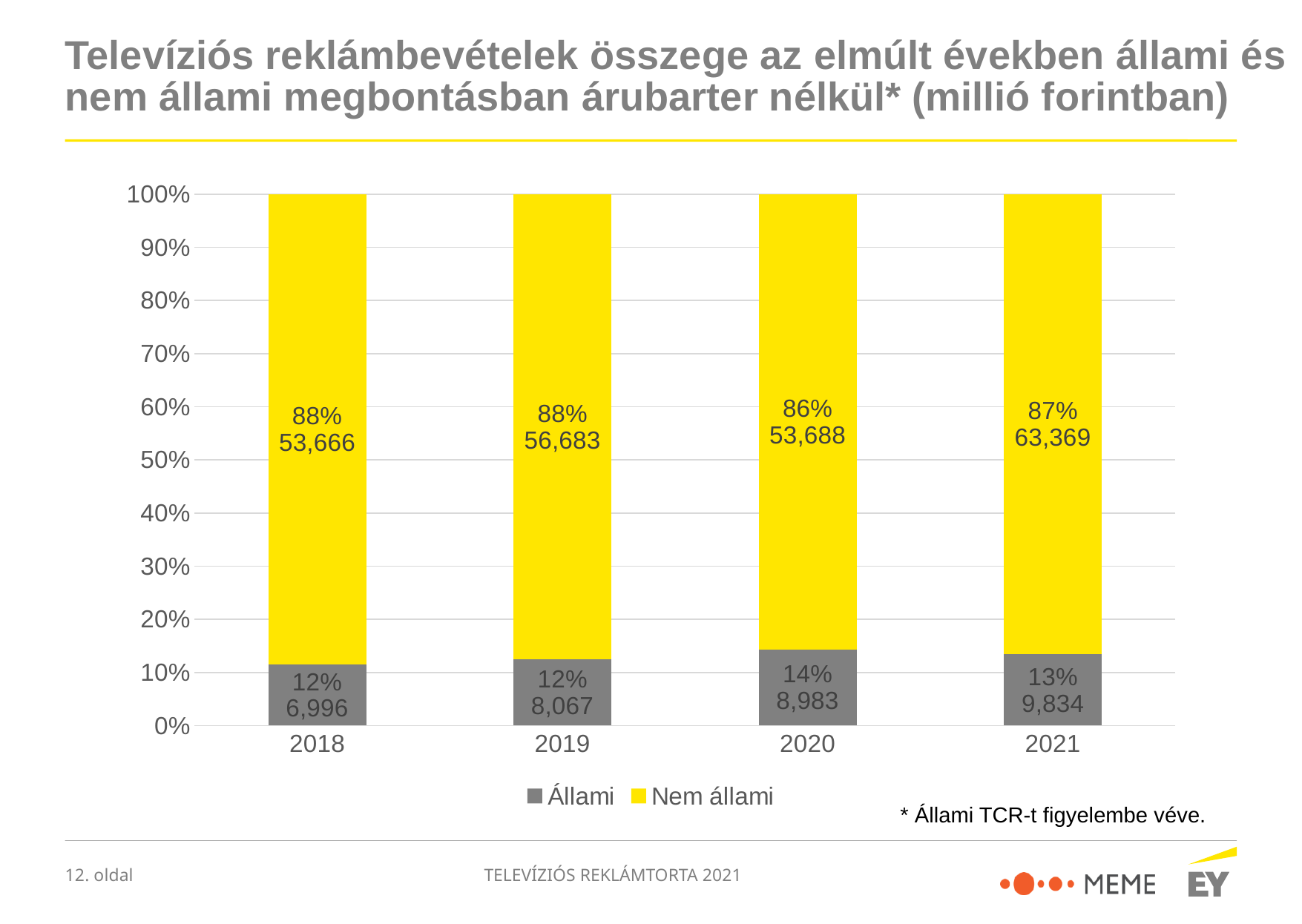
What is the total of the Állami and Nem állami values for 2018? 60,662 How many series does the legend list? 2 Which year has the lowest Állami value? 2018 Which year has the highest Nem állami value? 2021 What percentage share does Állami have in 2020? 14% Which is larger, the Állami value for 2019 or for 2020? 2020 What kind of chart is shown on the slide? Stacked bar chart What is the Nem állami value for 2019? 56,683 Which colour represents the Nem állami series? Yellow What is the difference between the Nem állami values for 2021 and 2020? 9,681 How many years are shown on the x axis? 4 What is the Állami value for 2021? 9,834